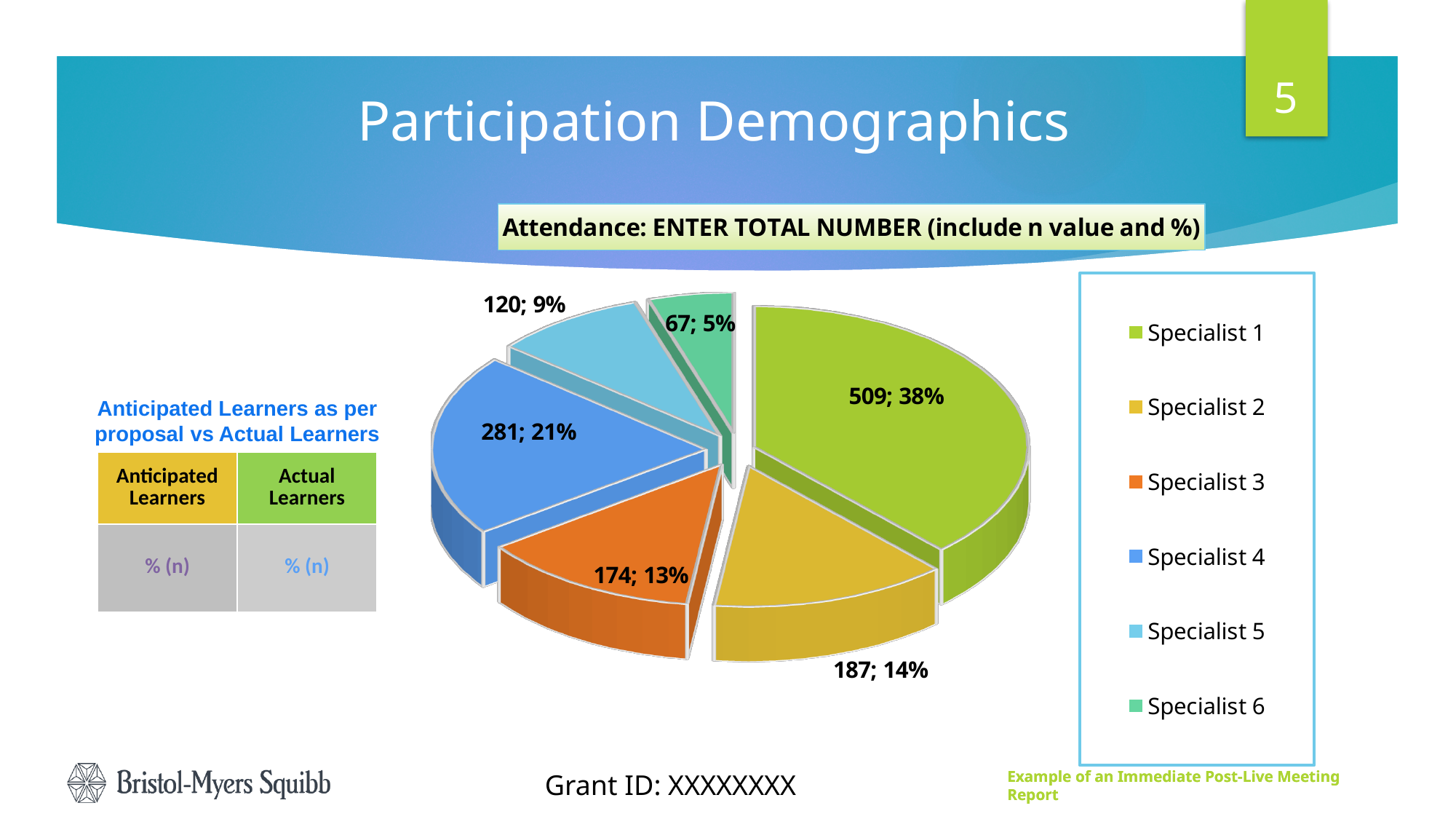
What value is shown for Specialist 4 in the pie chart? 281; 21% Which is larger, the count for Specialist 2 or Specialist 3? Specialist 2 What value is shown for Specialist 6 in the pie chart? 67; 5% What colour is the slice for Specialist 3 in the pie chart? orange What kind of chart is shown on the slide? pie chart Which specialist has the smallest slice of the pie chart? Specialist 6 How many entries does the legend of the pie chart list? 6 What share of the pie does Specialist 5 represent? 9% What is the difference between the counts for Specialist 1 and Specialist 4? 228 How many slices does the pie chart have? 6 Which specialist has the largest slice of the pie chart? Specialist 1 What value is shown for Specialist 1 in the pie chart? 509; 38%